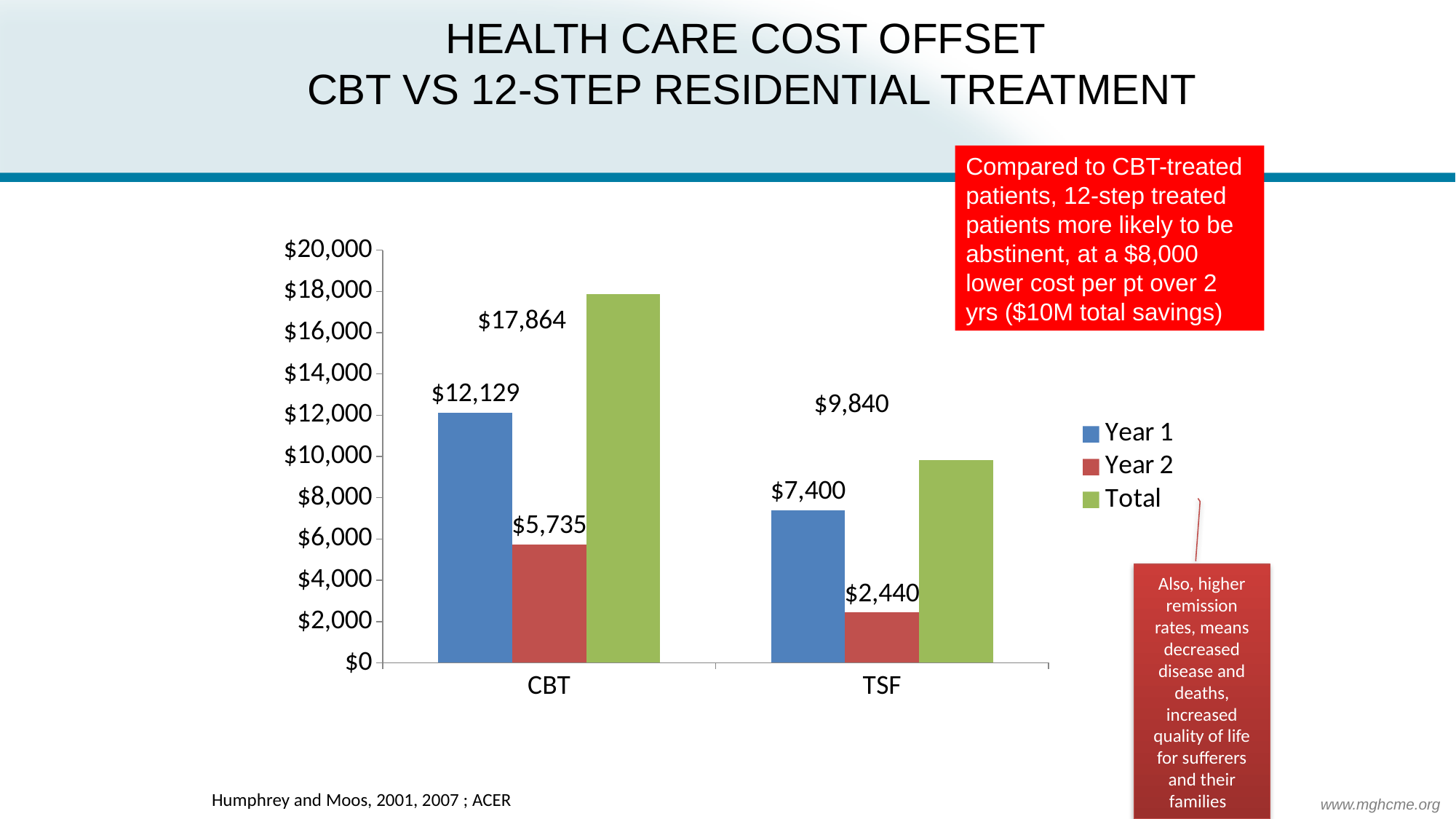
What kind of chart is shown on the slide? Bar chart What is the difference between the Total values for CBT and TSF? $8,024 What is the Total value for TSF? $9,840 What is the Year 2 value for CBT? $5,735 Which category has the higher Total value, CBT or TSF? CBT Which series has the lowest value for TSF? Year 2 What is the Year 1 value for CBT? $12,129 What is the Year 2 value for TSF? $2,440 How many categories are shown on the x axis? 2 Is the Year 1 value for TSF greater or less than $8,000? less What is the difference between the Year 1 values for CBT and TSF? $4,729 How many series does the legend list? 3